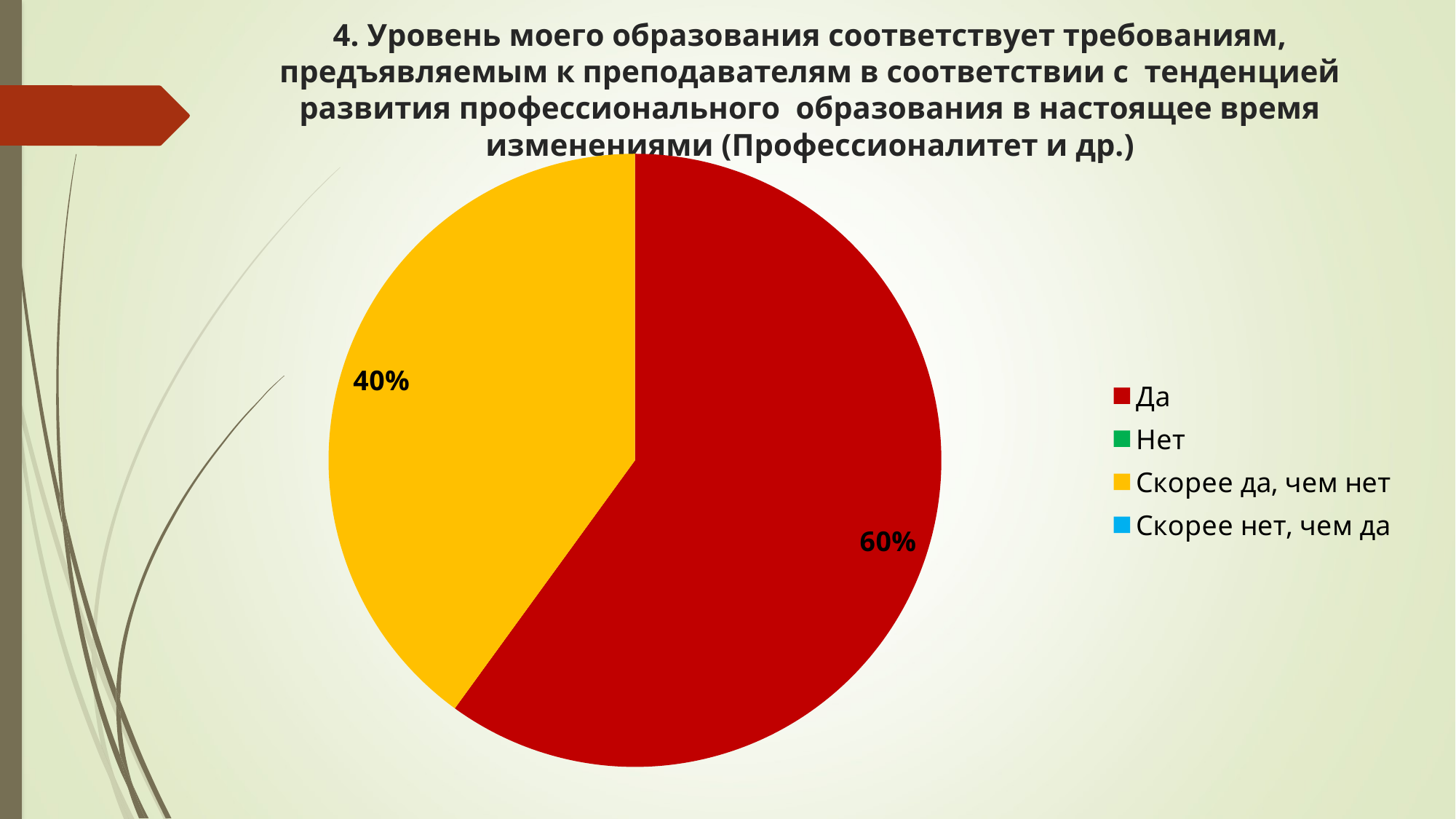
What share of the pie does "Да" take? 60% What is the difference in percentage points between the "Да" slice and the "Скорее да, чем нет" slice? 20% How many entries does the legend list? 4 Which legend entry is shown in red? Да What colour is the slice for "Скорее да, чем нет"? yellow How many slices are visible in the pie? 2 Which of the two visible slices is larger, "Да" or "Скорее да, чем нет"? Да What share of the pie does "Скорее да, чем нет" take? 40% What kind of chart is shown on the slide? pie chart Is the share for "Да" greater or less than 50%? greater Which category has the largest slice of the pie? Да